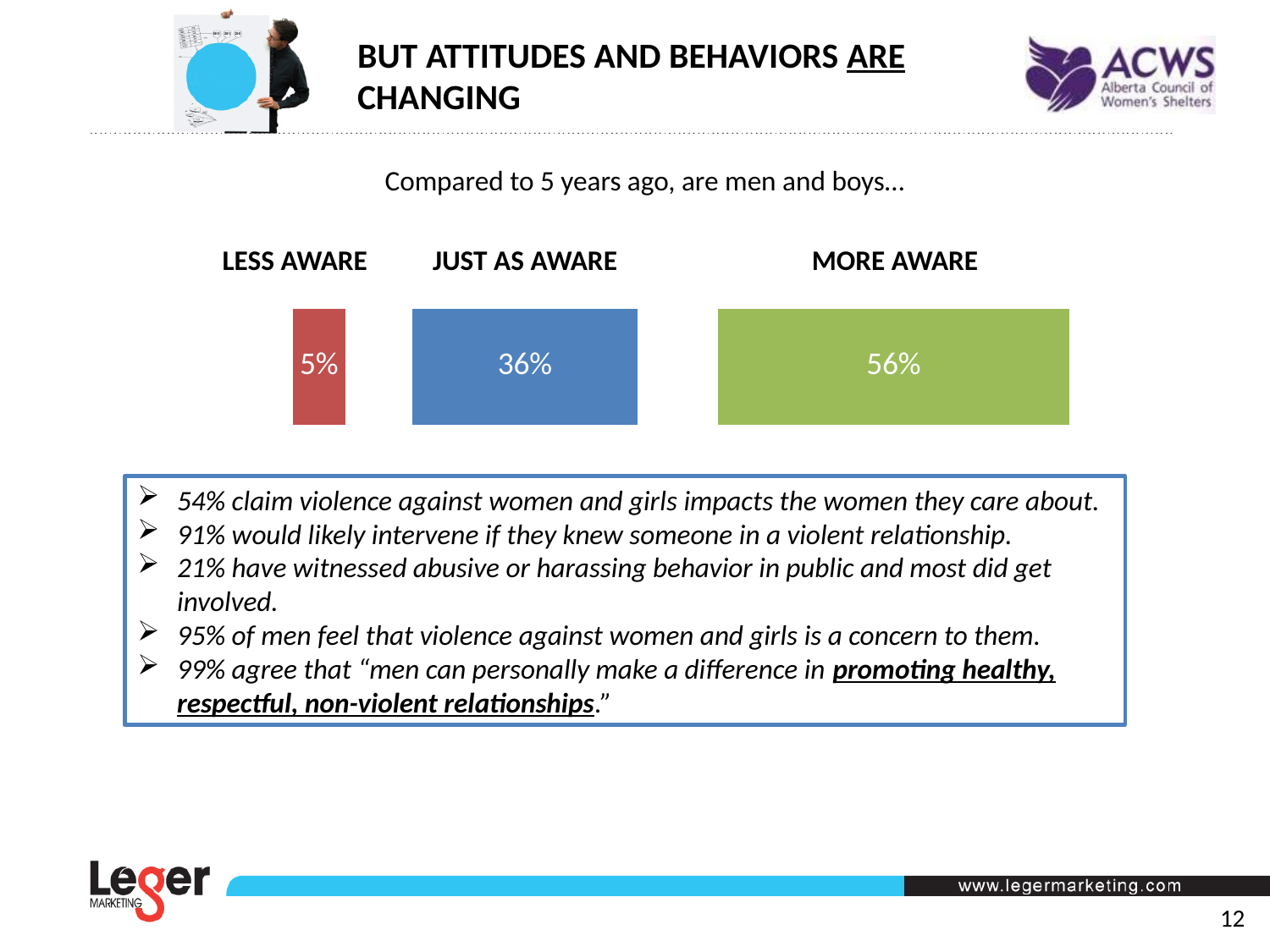
Which category has the lowest value in the chart? LESS AWARE What is the difference between the JUST AS AWARE and LESS AWARE values? 31% What kind of chart is shown on the slide? Bar chart What colour is the bar for MORE AWARE? Green What question does the chart answer, as stated above it? Compared to 5 years ago, are men and boys… What is the difference between the MORE AWARE and JUST AS AWARE values? 20% What percentage of respondents said men and boys are MORE AWARE compared to 5 years ago? 56% How many categories are shown in the chart? 3 What percentage of respondents said men and boys are JUST AS AWARE compared to 5 years ago? 36% What percentage of respondents said men and boys are LESS AWARE compared to 5 years ago? 5% Which category has the highest value in the chart? MORE AWARE Which is larger, the value for JUST AS AWARE or the value for LESS AWARE? JUST AS AWARE